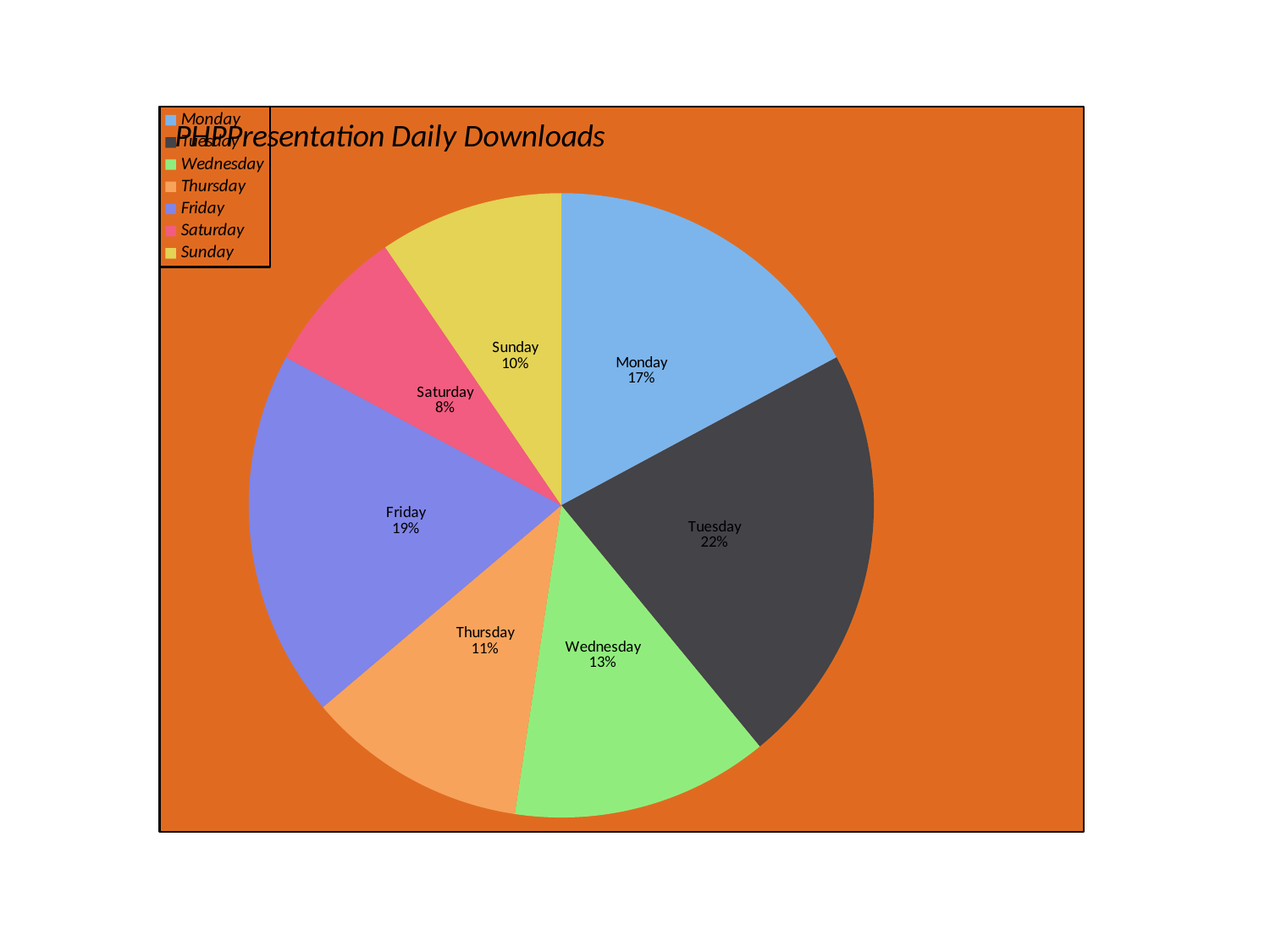
What percentage is shown for Wednesday? 13% Which day has the largest slice of the pie? Tuesday What share of the pie does Friday have? 19% What is the difference in percentage points between Tuesday and Sunday? 12 What share of the pie does Tuesday have? 22% What kind of chart is shown on the slide? pie chart What colour is the Friday slice? purple How many slices does the pie chart have? 7 Which day has the smallest slice of the pie? Saturday What percentage is shown for Saturday? 8% What is the title of the chart? PHPPresentation Daily Downloads Which is larger, the slice for Monday or the slice for Thursday? Monday